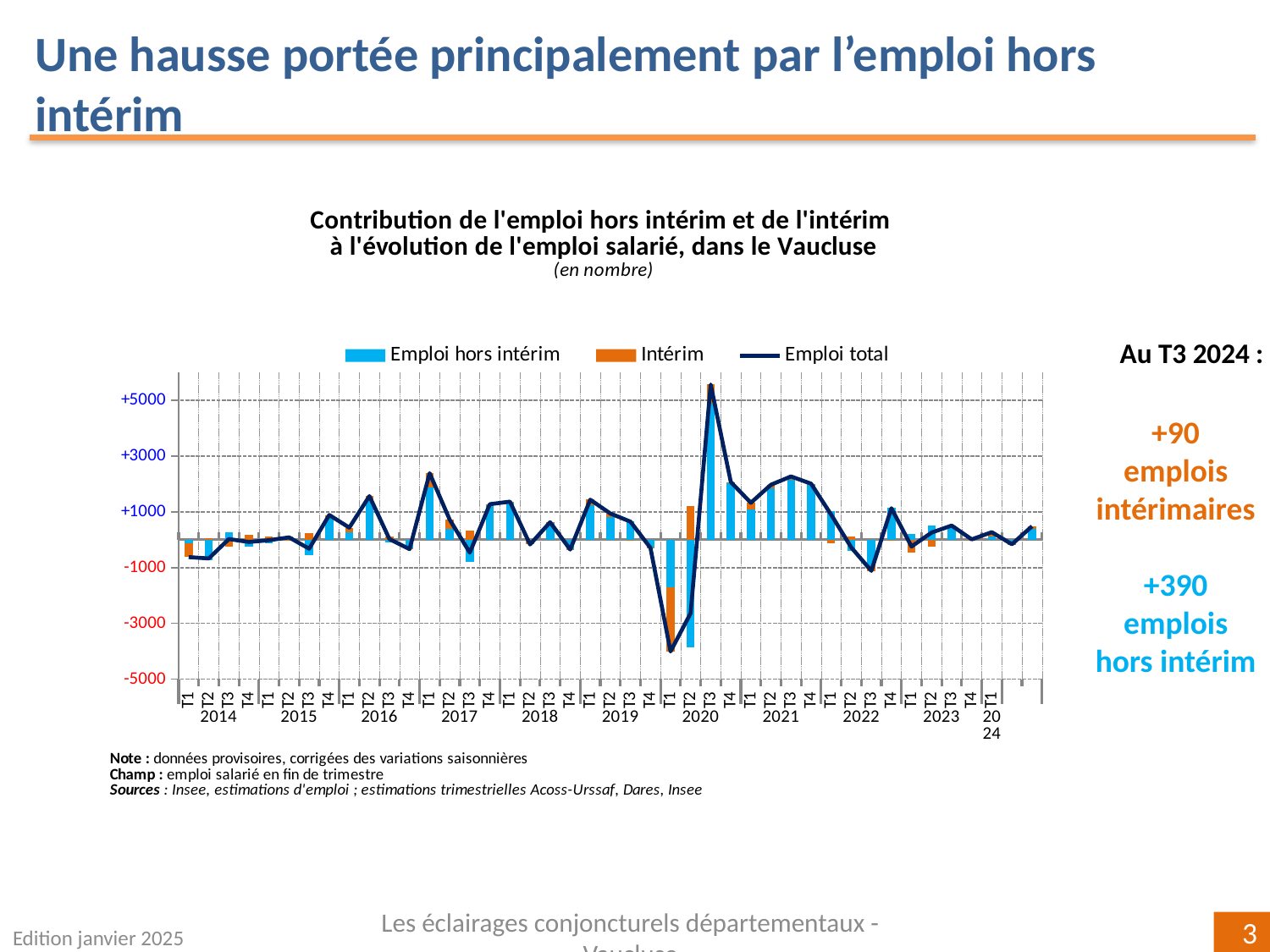
Which is larger, the Emploi total value at T1 2017 or at T1 2014? T1 2017 Is the value of Emploi total at T3 2022 greater or less than 0? less How many series does the chart legend list? 3 In which quarter does the Emploi total line reach its highest value? T3 2020 According to the slide, what is the contribution of non-interim employment (emplois hors intérim) at T3 2024? +390 What colour represents the Intérim series in the chart? Orange What is the total of the interim and non-interim contributions at T3 2024? +480 Is the value of Emploi total at T1 2020 greater or less than -3000? less What kind of chart is shown on the slide? Combined bar and line chart In which quarter does the Emploi total line reach its lowest value? T1 2020 According to the slide, what is the contribution of interim employment (emplois intérimaires) at T3 2024? +90 Is the value of Emploi total at T3 2020 greater or less than +5000? greater